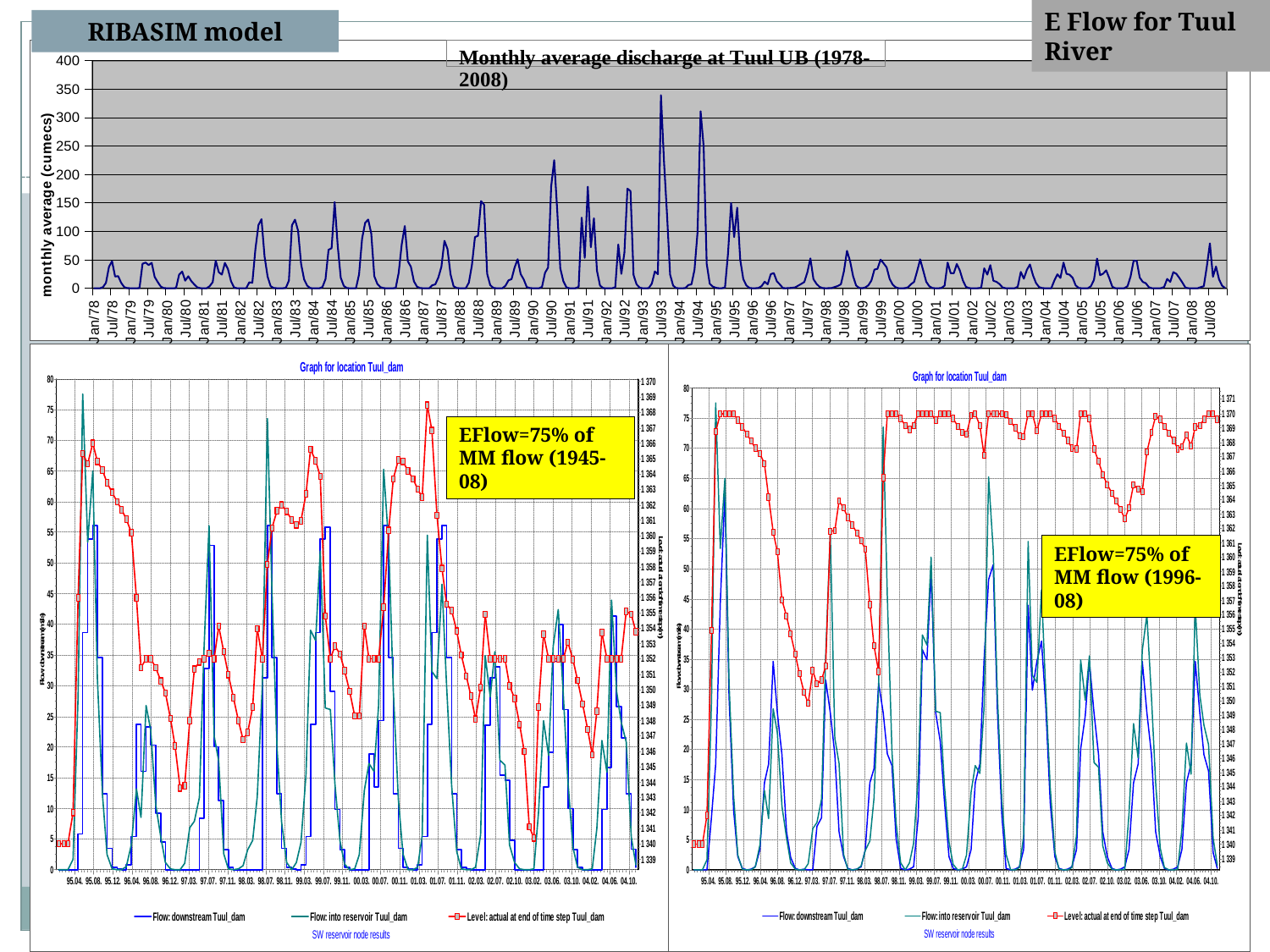
In the top chart 'Monthly average discharge at Tuul UB (1978-2008)', is the value at Jan/78 greater or less than 50? less In the bottom-right chart 'Graph for location Tuul_dam', is the 'Level: actual at end of time step Tuul_dam' value at 95.08 greater or less than 1365? greater How many series does the legend list in the bottom-left chart 'Graph for location Tuul_dam'? 3 In the top chart 'Monthly average discharge at Tuul UB (1978-2008)', around which month does the highest peak occur? Jul/93 In the top chart 'Monthly average discharge at Tuul UB (1978-2008)', is the peak value around Jul/90 greater or less than 200? greater How many series does the legend list in the bottom-right chart 'Graph for location Tuul_dam'? 3 What is the y-axis label of the top chart 'Monthly average discharge at Tuul UB (1978-2008)'? monthly average (cumecs) What kind of chart is the bottom-left chart 'Graph for location Tuul_dam'? line chart What is the title of the bottom-right chart on the slide? Graph for location Tuul_dam What kind of chart is the top chart titled 'Monthly average discharge at Tuul UB (1978-2008)'? line chart